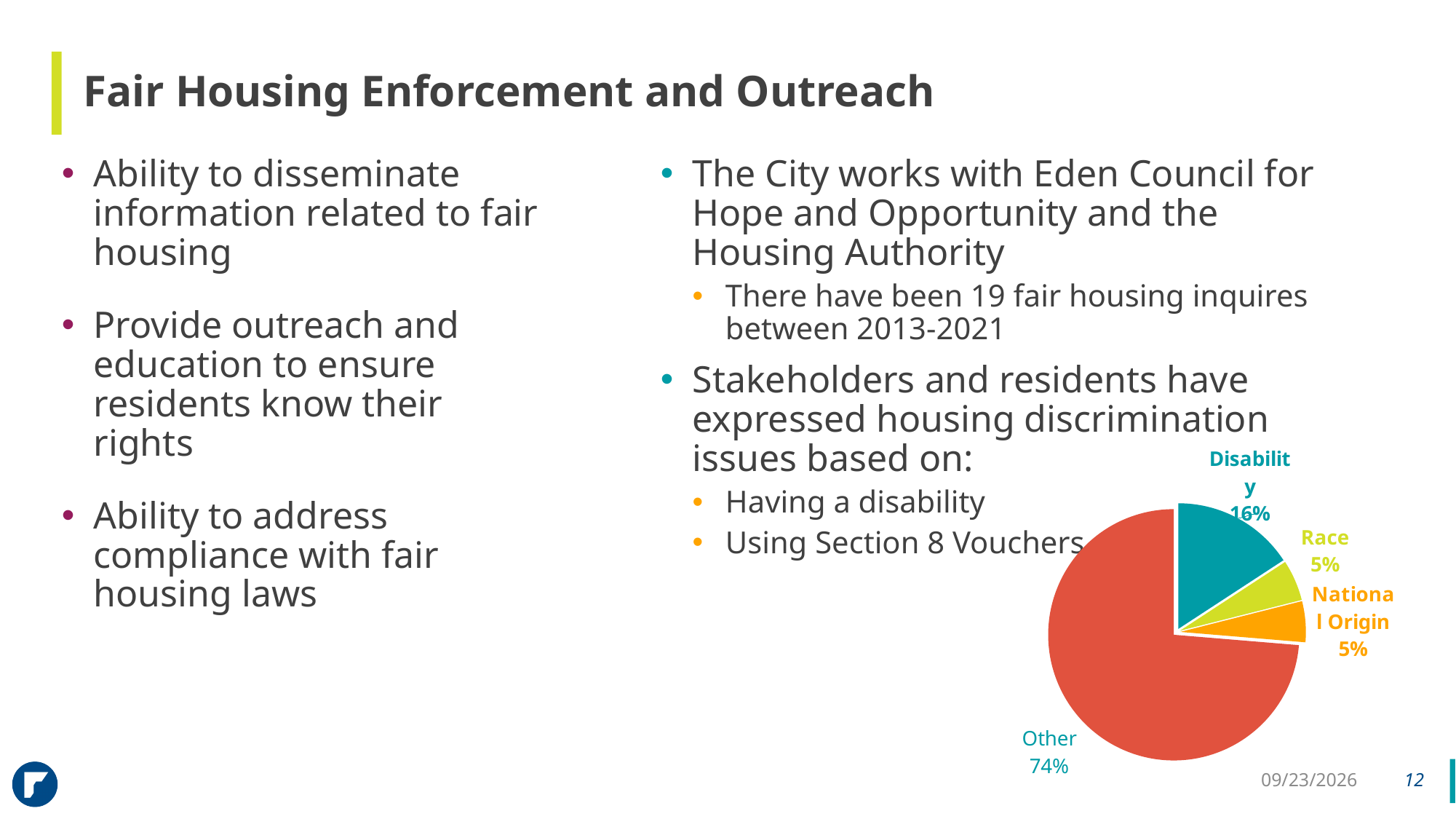
How many slices does the pie chart have? 4 What share of the pie does Race represent? 5% What share of the pie does Other represent? 74% Which is larger, the Disability slice or the Race slice? Disability What kind of chart is shown on the slide? pie chart What share of the pie does National Origin represent? 5% What colour is the Other slice of the pie chart? red What is the difference in percentage points between the Other slice and the Disability slice? 58 What colour is the Disability slice of the pie chart? teal What is the difference in percentage points between the Disability slice and the National Origin slice? 11 Which slice of the pie chart is the largest? Other What share of the pie does Disability represent? 16%